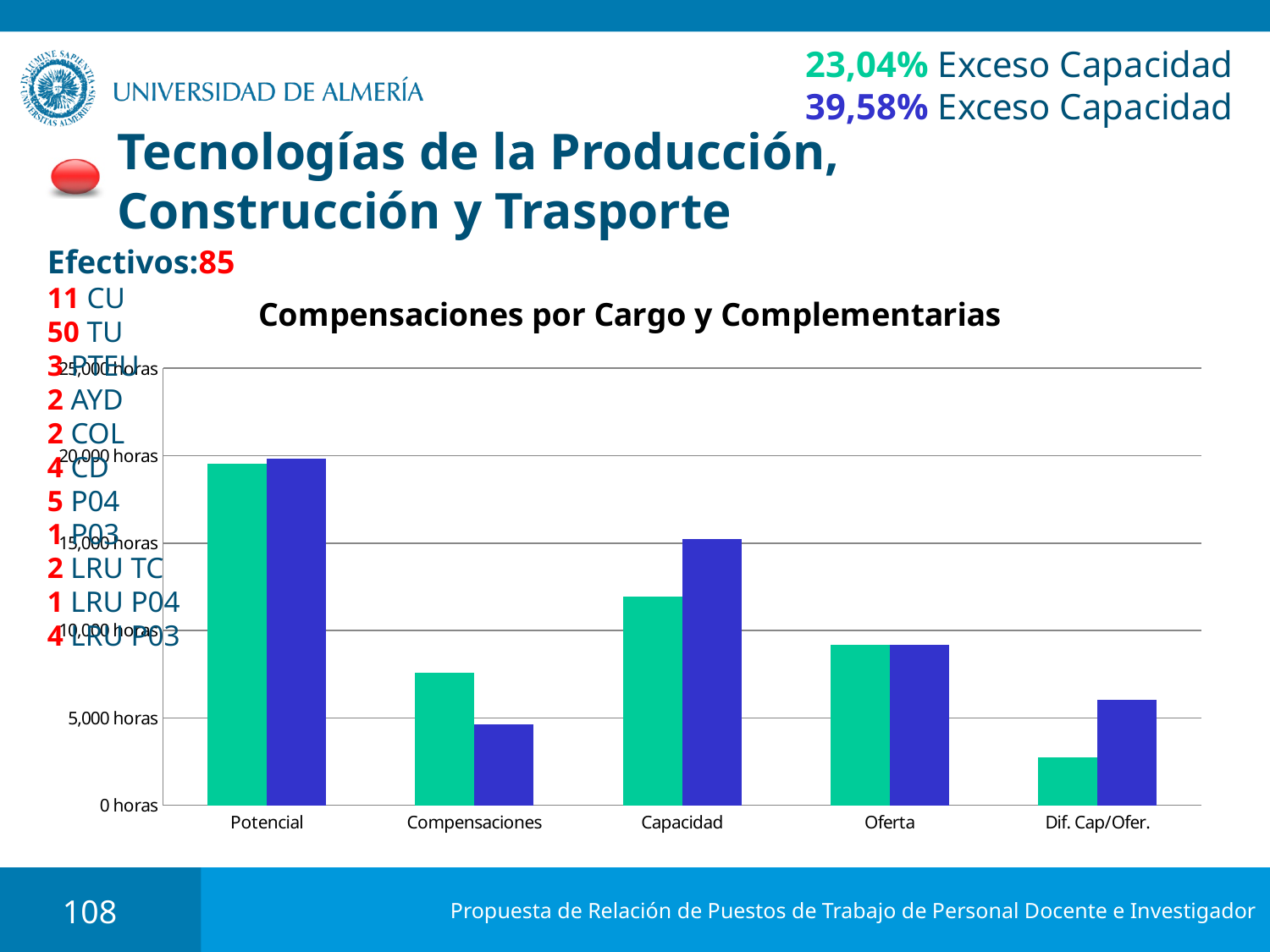
Which category has the shortest green bar? Dif. Cap/Ofer. Which category has the tallest green bar? Potencial What is the title of the chart? Compensaciones por Cargo y Complementarias Which category has the tallest blue bar? Potencial How many categories are shown on the x axis of the chart? 5 Is the green bar for Potencial greater or less than 15,000 horas? greater Is the green bar for Compensaciones greater or less than 10,000 horas? less For Compensaciones, which bar is taller, the green one or the blue one? green What kind of chart is shown under the title 'Compensaciones por Cargo y Complementarias'? bar chart For Dif. Cap/Ofer., which bar is taller, the green one or the blue one? blue Which category has the shortest blue bar? Compensaciones